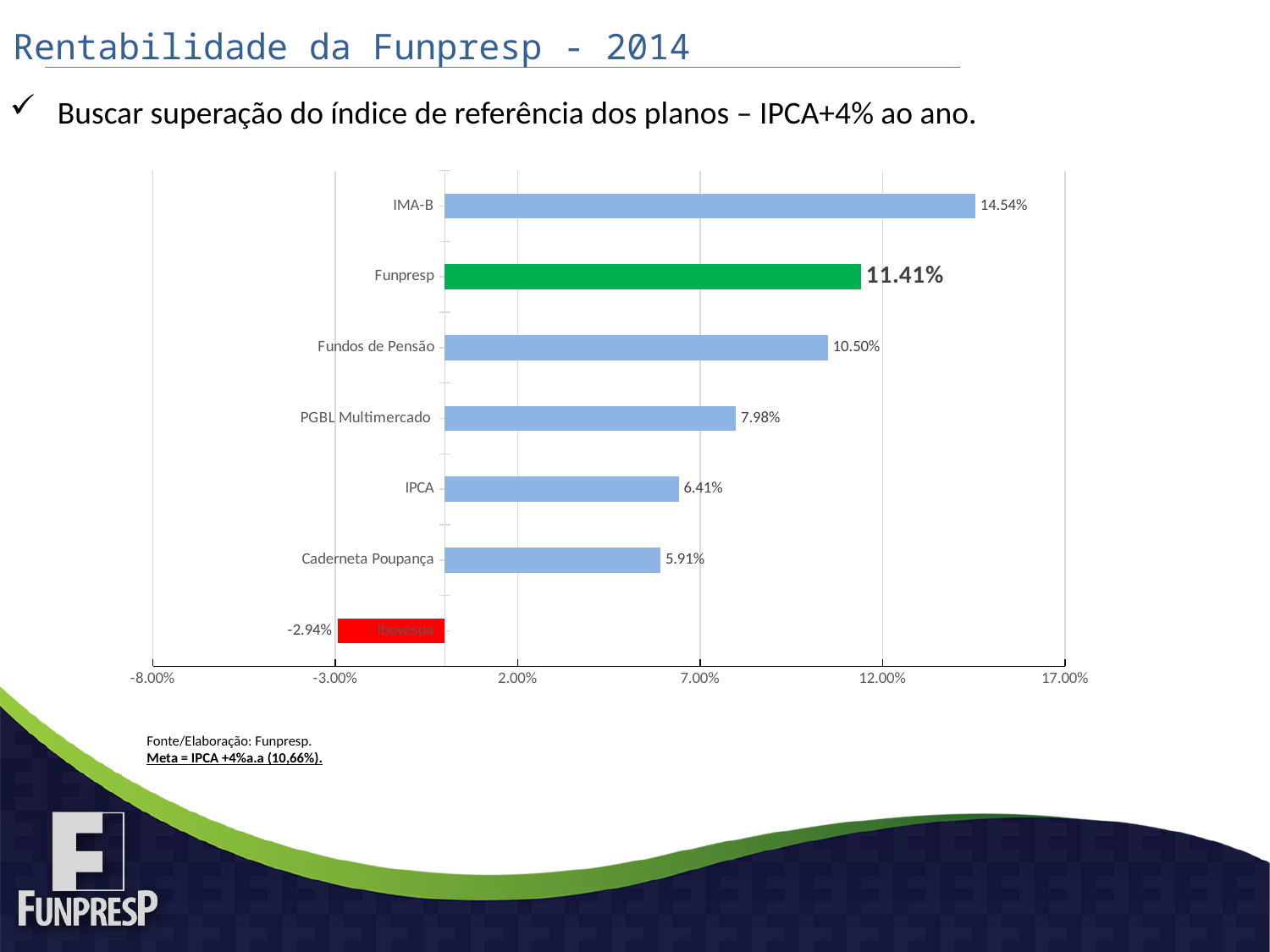
What is the value shown for Funpresp? 11.41% Which category has the highest value? IMA-B What is the difference between the Funpresp value and the IPCA value? 5.00 percentage points Which category has the lowest value? Ibovespa Which is larger, the value for Fundos de Pensão or the value for PGBL Multimercado? Fundos de Pensão What is the difference between the IMA-B value and the Funpresp value? 3.13 percentage points What is the value shown for Ibovespa? -2.94% What kind of chart is shown on the slide? Bar chart What is the value shown for IMA-B? 14.54% What is the value shown for Caderneta Poupança? 5.91% How many categories are plotted in the chart? 7 What colour is the Funpresp bar? Green